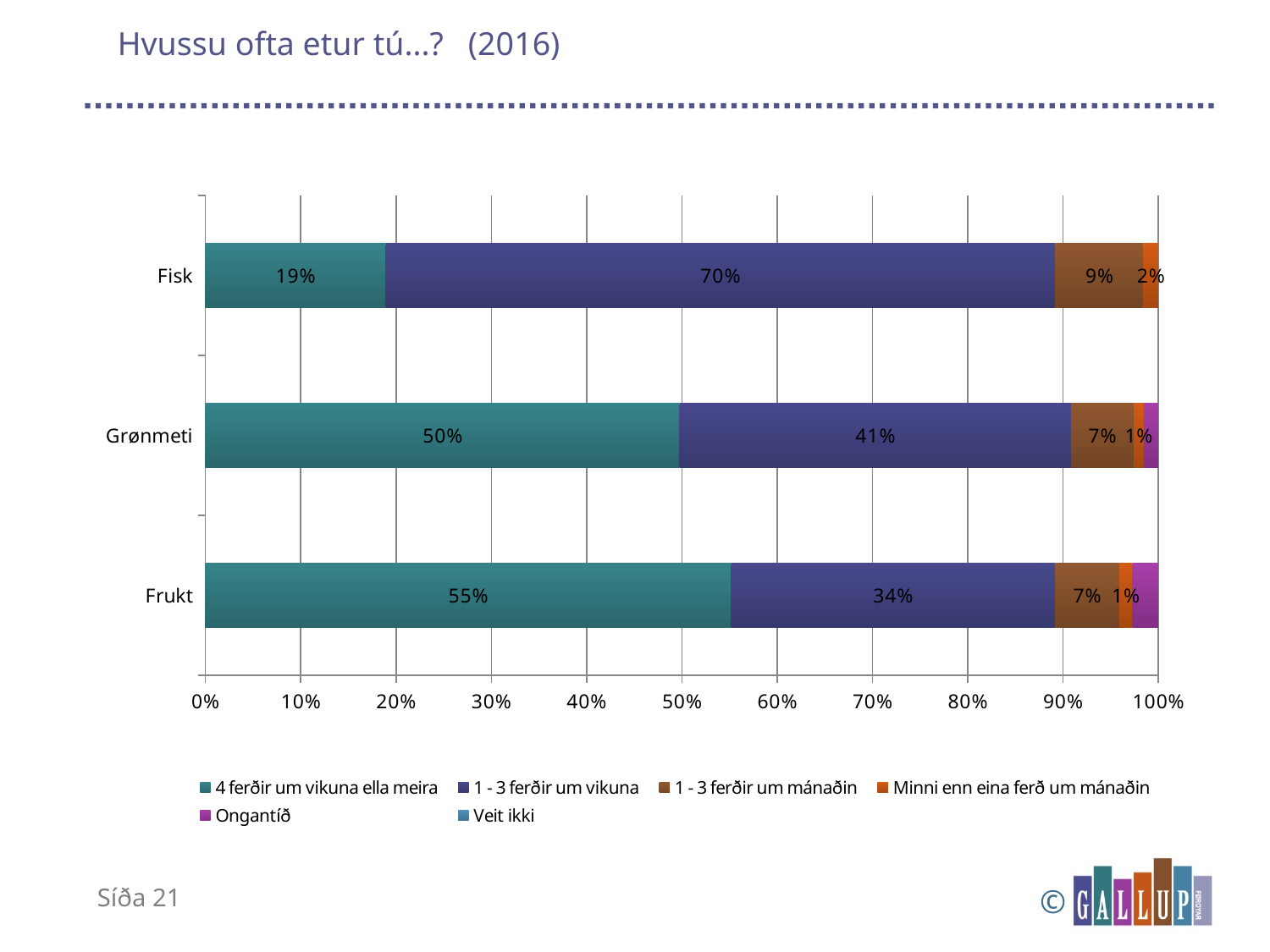
What is the difference between the '1 - 3 ferðir um vikuna' values for Fisk and Grønmeti? 29% How many series does the legend list? 6 Which category has the highest value for '4 ferðir um vikuna ella meira'? Frukt Which category has the lowest value for '1 - 3 ferðir um vikuna'? Frukt What is the value for '4 ferðir um vikuna ella meira' for Fisk? 19% What is the value for '1 - 3 ferðir um vikuna' for Fisk? 70% How many food categories are shown on the chart? 3 What is the title of the chart slide? Hvussu ofta etur tú...? (2016) What kind of chart is shown on the slide? Stacked bar chart What is the value for '1 - 3 ferðir um mánaðin' for Grønmeti? 7% What is the value for '4 ferðir um vikuna ella meira' for Frukt? 55% Which is larger: the '4 ferðir um vikuna ella meira' value for Grønmeti or for Fisk? Grønmeti